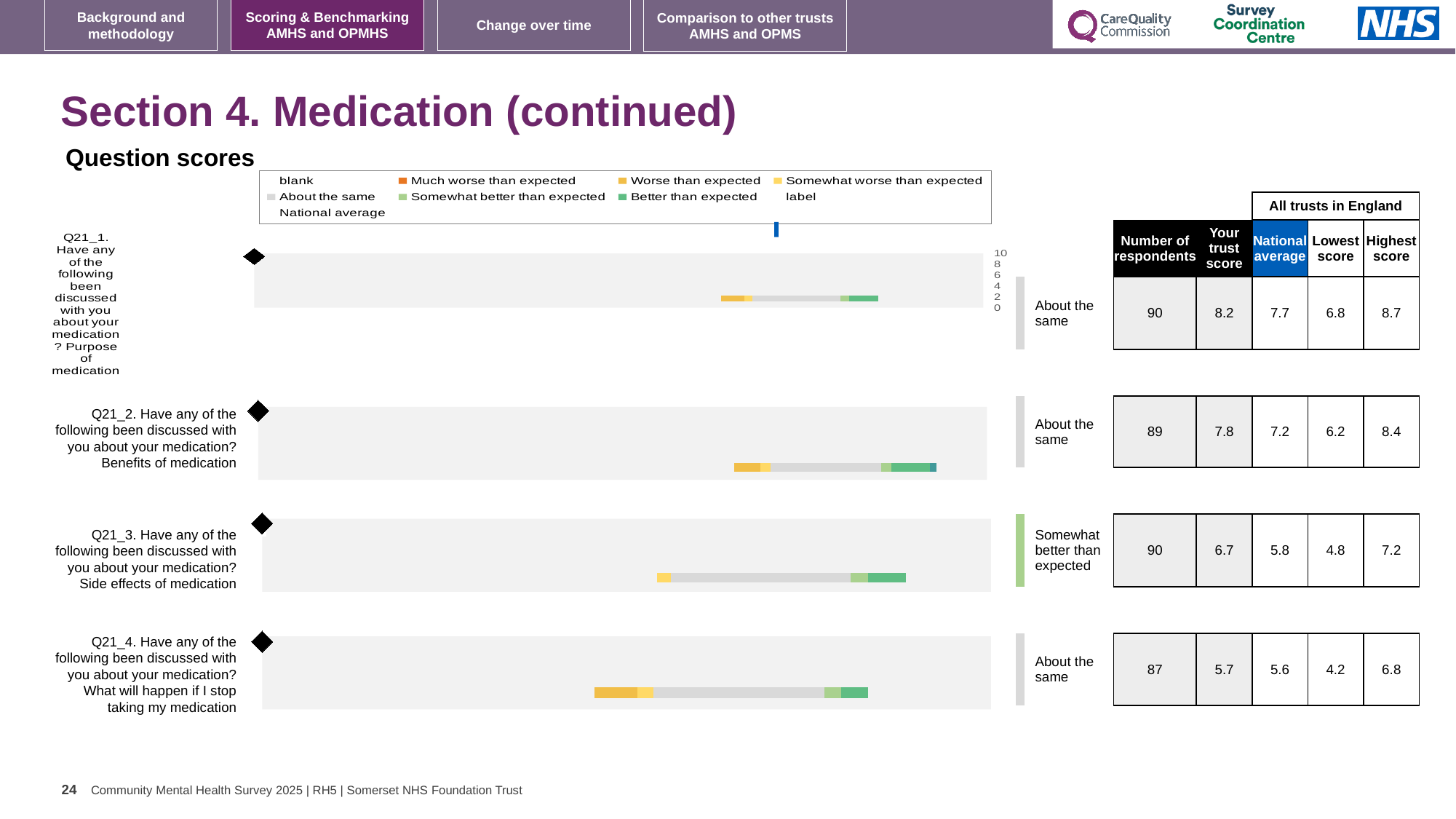
How many question-score charts are shown on the slide? 4 What is the heading above the charts? Question scores What is the highest tick value on the axis shown beside the Q21_1 chart? 10 Which question's chart is labelled 'Somewhat better than expected' to its right? Q21_3 How many entries does the legend above the charts list? 9 What is the lowest tick value on the axis shown beside the Q21_1 chart? 0 In the legend, what colour represents 'Much worse than expected'? orange What kind of chart is used for the Q21_1 question score? bar chart